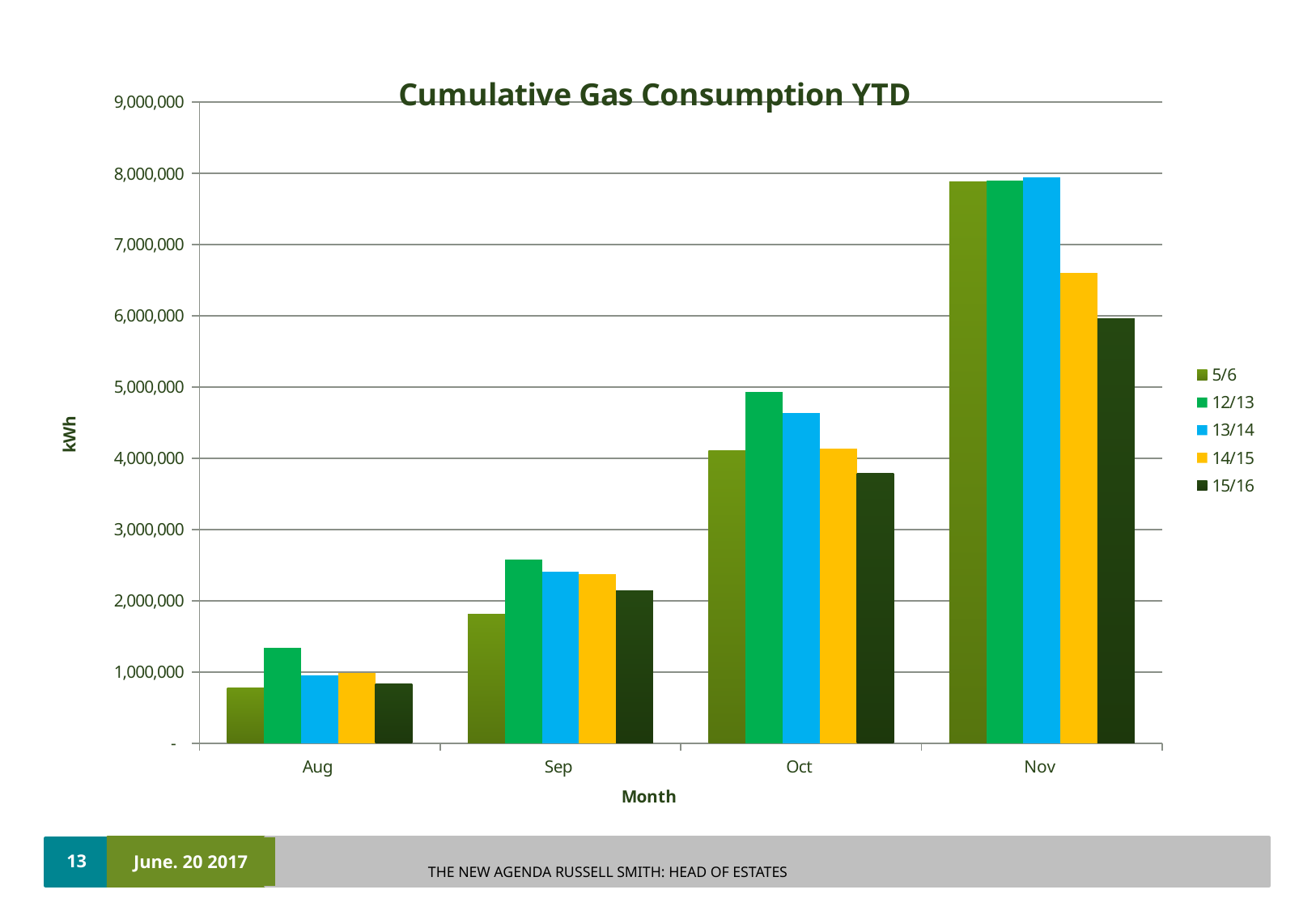
Which series has the highest cumulative gas consumption in Oct? 12/13 Which series has the lowest cumulative gas consumption in Nov? 15/16 Is the value for 14/15 in Nov greater or less than 7,000,000? less How many months are shown on the x axis? 4 Is the value for 12/13 in Aug greater or less than 1,000,000? greater What type of chart is shown on the slide? bar chart Which series has the highest cumulative gas consumption in Aug? 12/13 In Oct, which is larger: the value for 13/14 or the value for 14/15? 13/14 Is the value for 5/6 in Oct greater or less than 4,000,000? greater What is the label on the y axis? kWh How many series does the legend list? 5 Do the values for the 15/16 series rise or fall from Aug to Nov? rise